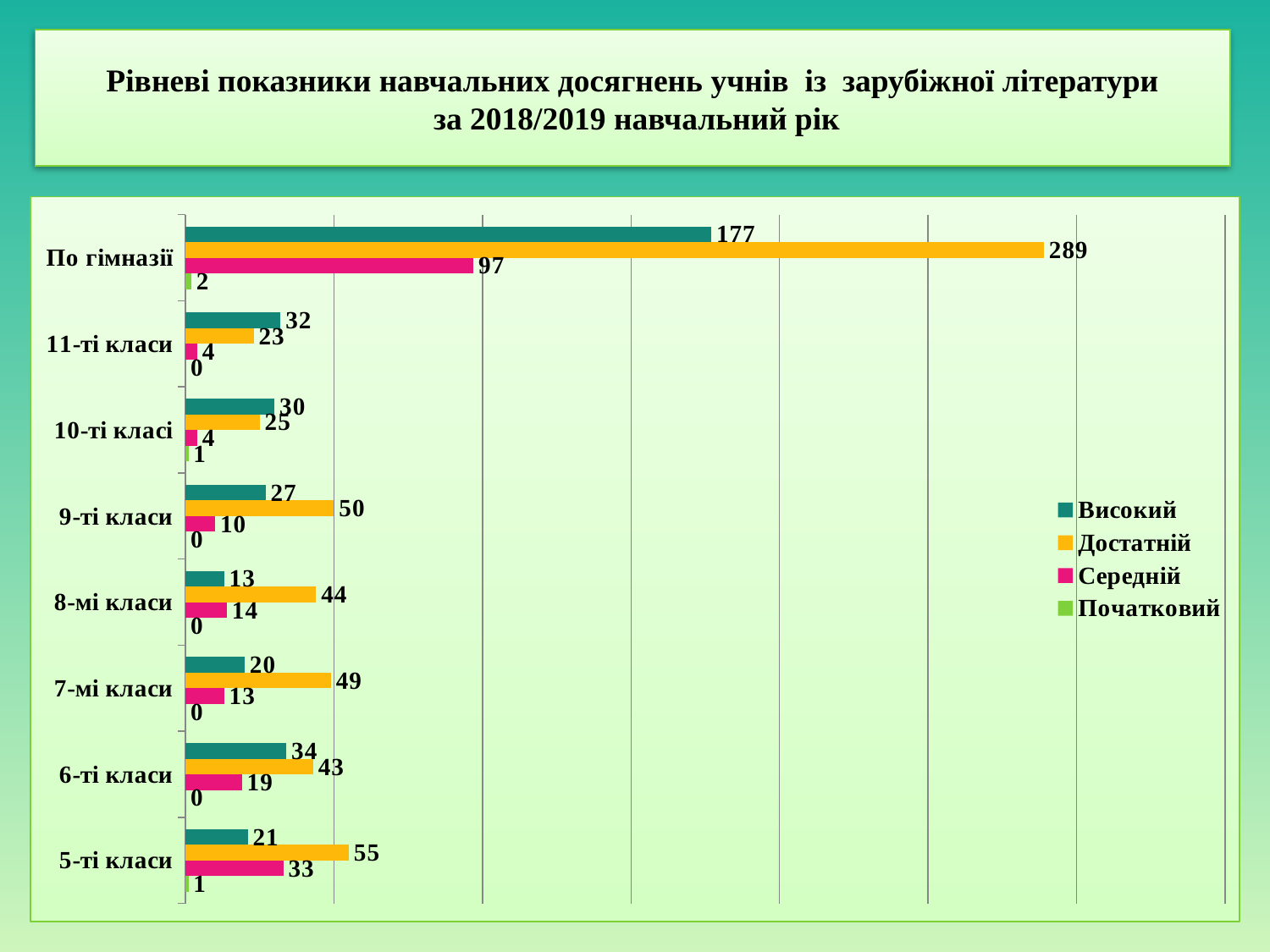
Which class category has the lowest Високий value? 8-мі класи How many categories are shown on the vertical axis? 8 What is the value for Високий for 11-ті класи? 32 What is the difference between the Достатній and Високий values for По гімназії? 112 How many series does the legend list? 4 What is the value for Середній for 5-ті класи? 33 Which class category has the highest Достатній value, excluding По гімназії? 5-ті класи Which series is shown in pink? Середній What is the value for Достатній for По гімназії? 289 Which is larger for 6-ті класи: Високий or Достатній? Достатній What is the value for Початковий for 10-ті класі? 1 What kind of chart is shown on the slide? bar chart